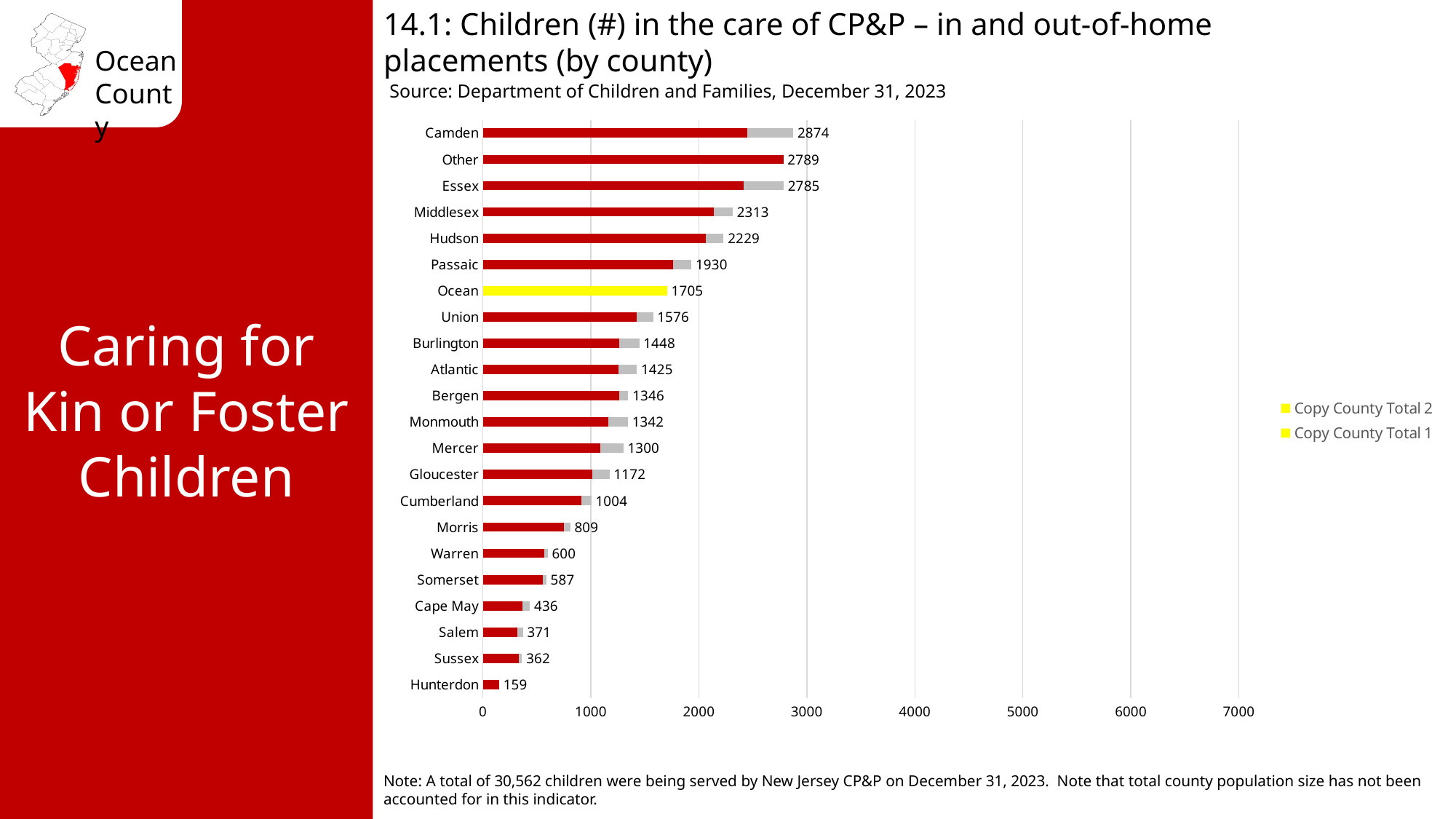
What is the total number of children in the care of CP&P for Ocean County? 1705 What is the total value shown for Camden? 2874 What kind of chart is shown on the slide? Bar chart What is the difference between the totals for Camden and Ocean? 1169 Is the total for Middlesex greater or less than 2000? greater What is the total value shown for Hunterdon? 159 Which county has the highest total number of children in the care of CP&P? Camden How many counties (categories) are shown on the chart? 22 Which has a larger total, Passaic or Union? Passaic Which county has the lowest total number of children in the care of CP&P? Hunterdon How many series does the legend list? 2 Which county's bar is highlighted in yellow? Ocean